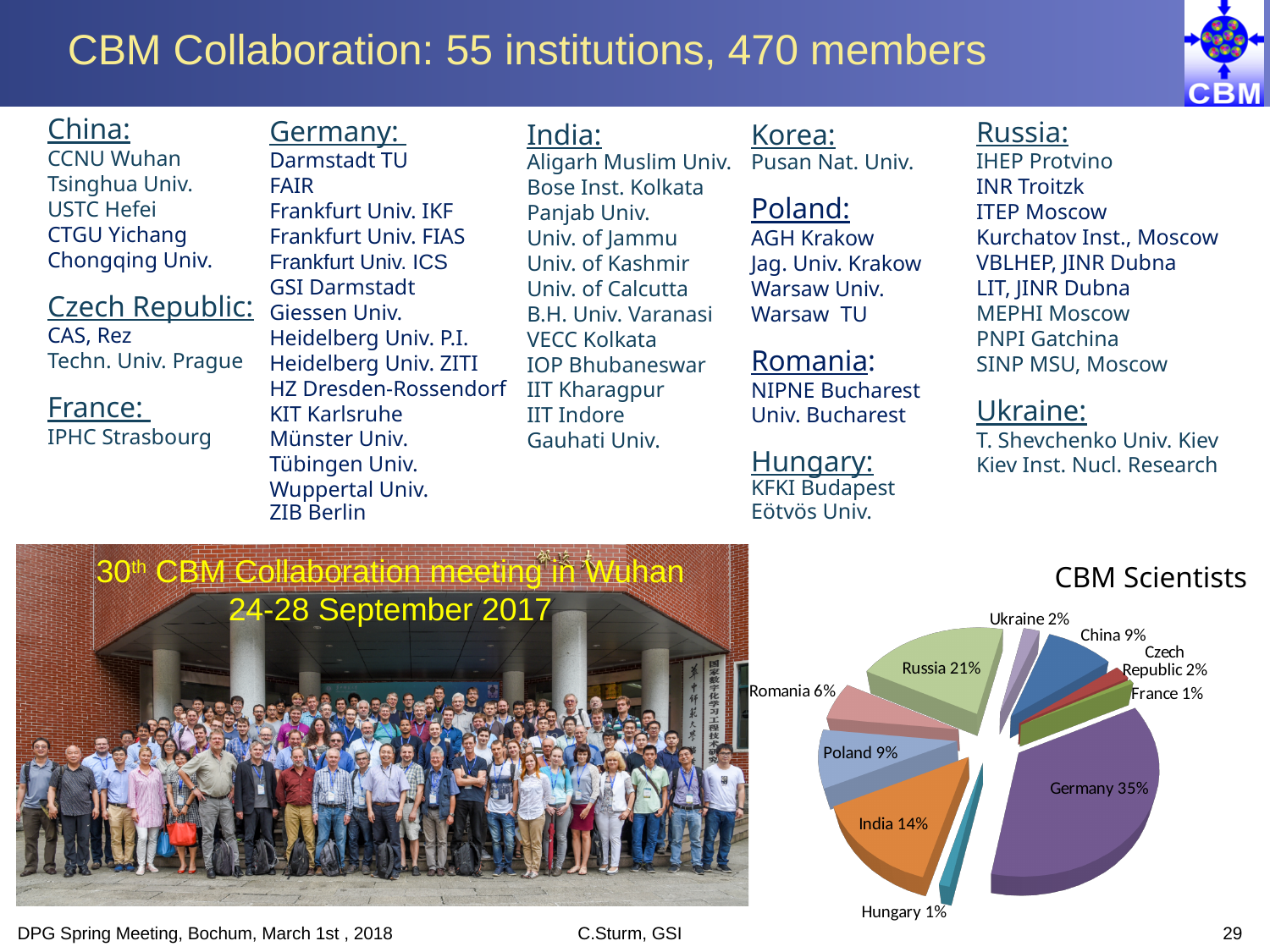
In the CBM Scientists pie chart, what share of scientists comes from Romania? 6% In the CBM Scientists pie chart, what is the difference between the shares of Germany and Russia? 14% What kind of chart is shown under the title "CBM Scientists"? pie chart How many slices does the CBM Scientists pie chart have? 10 In the CBM Scientists pie chart, which country has the largest share? Germany In the CBM Scientists pie chart, what share of scientists comes from Russia? 21% In the CBM Scientists pie chart, what share of scientists comes from Germany? 35% In the CBM Scientists pie chart, which country has a larger share, Poland or Romania? Poland In the CBM Scientists pie chart, what is the difference between the shares of India and China? 5% What is the title of the pie chart on the slide? CBM Scientists In the CBM Scientists pie chart, what share of scientists comes from India? 14%